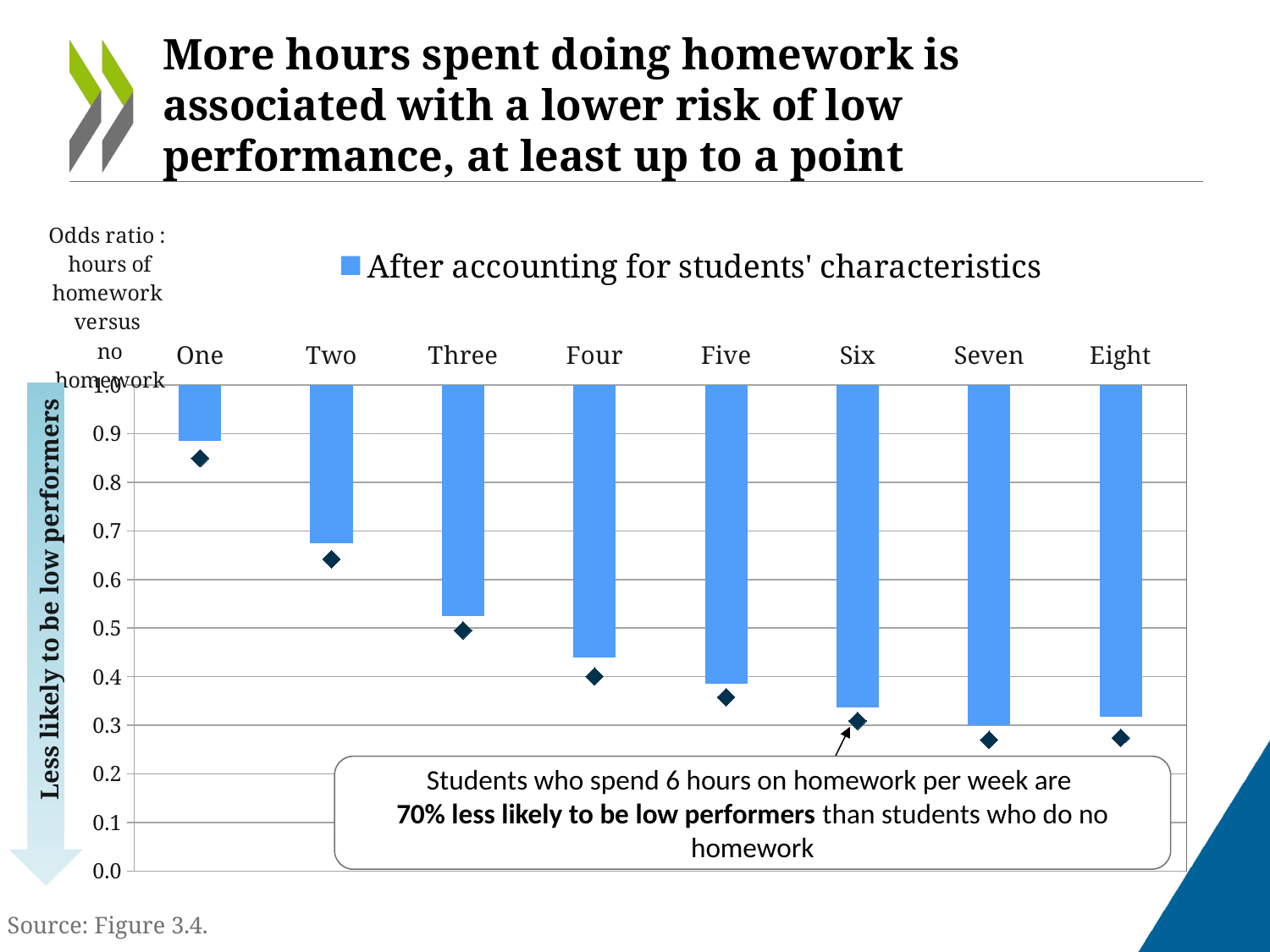
Is the odds ratio for Two greater or less than 0.7? less Which has the larger odds ratio, Two or Five? Two Is the odds ratio for One greater or less than 0.8? greater How many series does the legend list? 1 How many categories of homework hours are shown on the x axis? 8 Is the odds ratio for Six greater or less than 0.4? less Do the odds ratios generally rise or fall as the hours of homework increase from One to Seven? fall What series name does the legend show? After accounting for students' characteristics Which category has the highest odds ratio? One What kind of chart is shown on the slide? bar chart